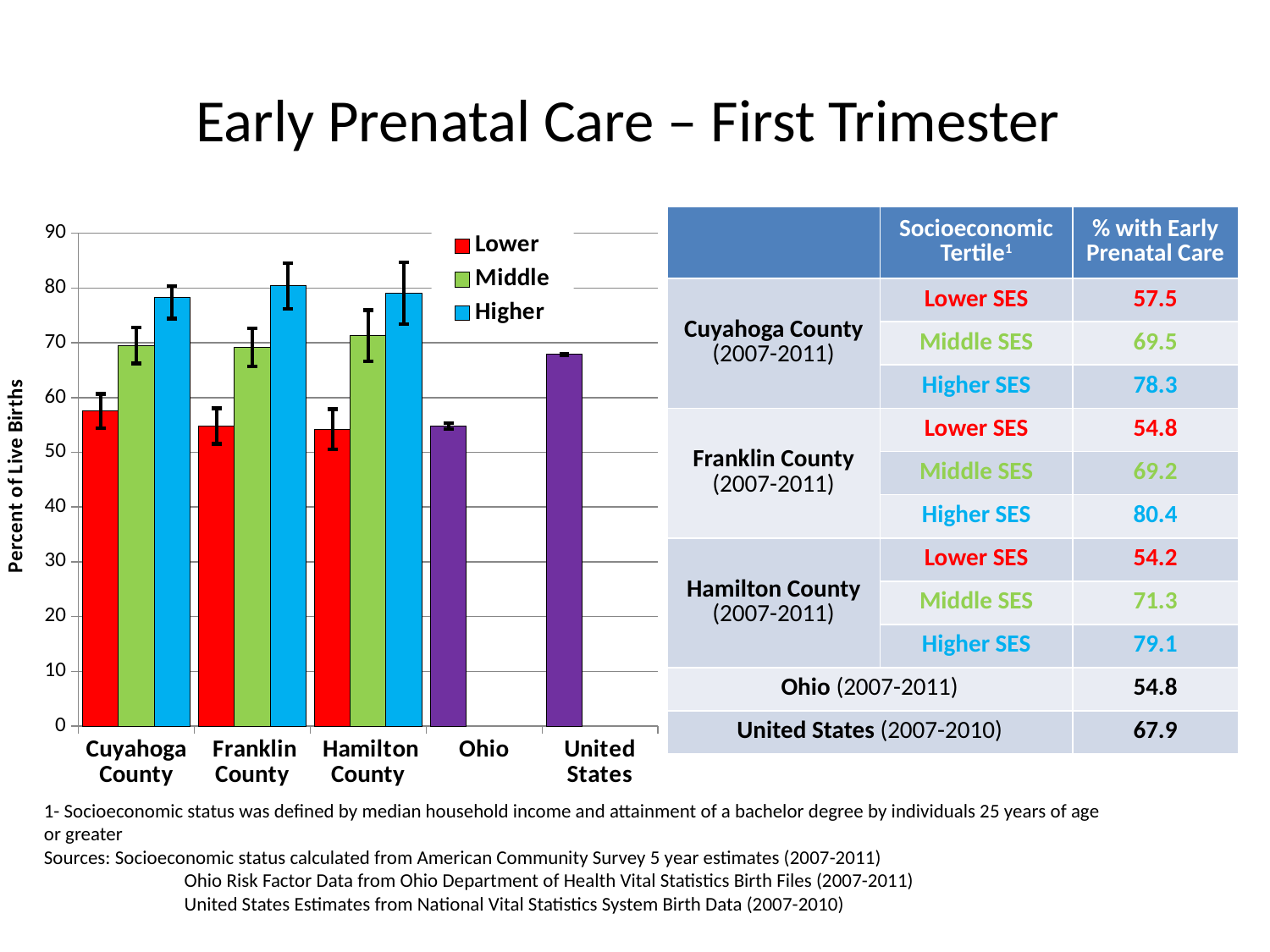
What is the difference between the Higher SES and Lower SES percentages in Cuyahoga County? 20.8 What is the percent with early prenatal care for the Lower SES group in Cuyahoga County? 57.5 How many categories are shown along the x axis of the chart? 5 What is the percent with early prenatal care for the Higher SES group in Franklin County? 80.4 What type of chart is shown on the slide? bar chart What colour are the Higher series bars in the chart? blue What is the percent with early prenatal care for the United States? 67.9 Which socioeconomic tertile has the highest percent with early prenatal care in Hamilton County? Higher SES Which county has the lowest Lower SES percent with early prenatal care? Hamilton County Is the Middle SES value for Hamilton County greater or less than 70? greater How many series does the chart legend list? 3 Which is larger, the Ohio value or the United States value? United States